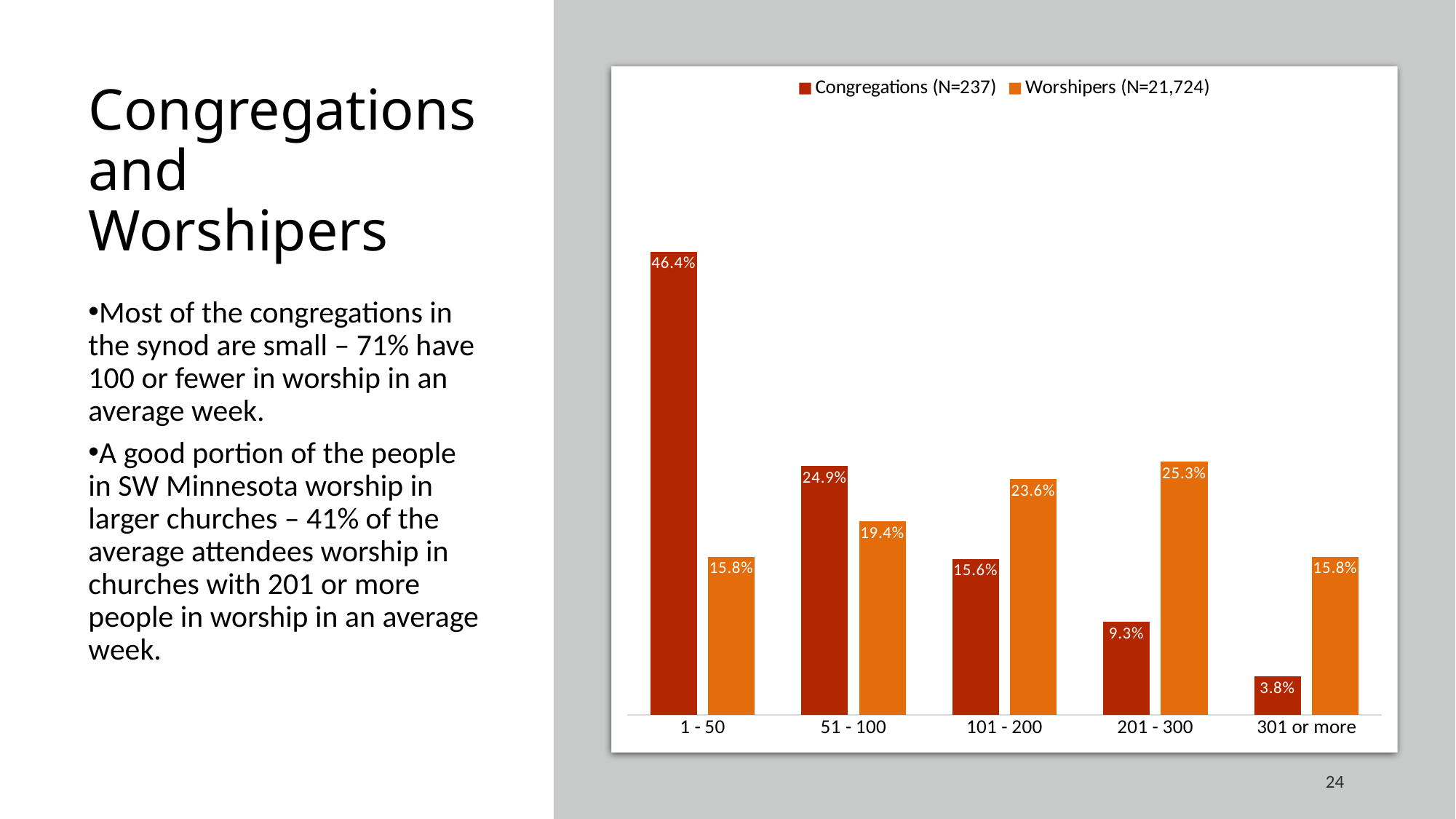
How many series does the legend list? 2 What is the value for Congregations in the 301 or more category? 3.8% What is the N value given in the legend for Worshipers? 21,724 How many categories are shown on the x axis? 5 What percentage of worshipers are in the 201 - 300 category? 25.3% Which category has the lowest value for Congregations? 301 or more What kind of chart is shown on the slide? Bar chart Do the Congregations values rise or fall as you move from 1 - 50 to 301 or more? Fall What is the difference between the Congregations and Worshipers values in the 1 - 50 category? 30.6% Which category has the highest value for Worshipers? 201 - 300 In the 101 - 200 category, which series has the larger value, Congregations or Worshipers? Worshipers What percentage of congregations are in the 1 - 50 category? 46.4%